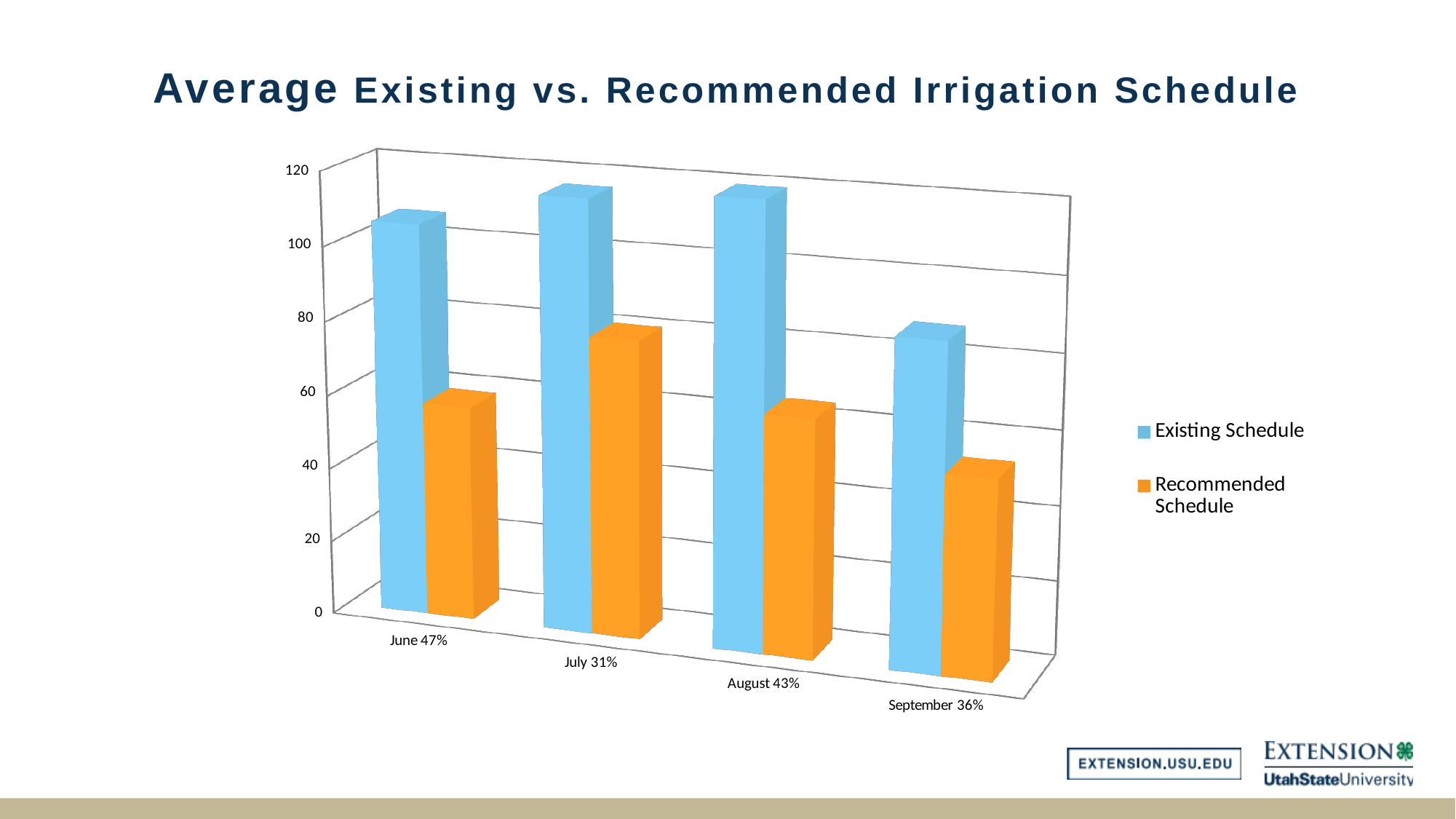
Which colour represents the Recommended Schedule series in the legend? orange How many series does the legend list? 2 What kind of chart is shown on the slide? bar chart For August 43%, which is larger: the Existing Schedule or the Recommended Schedule? Existing Schedule Which month has the lowest Existing Schedule value? September 36% Is the Recommended Schedule value for September 36% greater or less than 60? less Which month has the lowest Recommended Schedule value? September 36% Is the Recommended Schedule value for June 47% greater or less than 80? less Is the Existing Schedule value for September 36% greater or less than 100? less How many months (categories) are shown on the x axis? 4 Which month has the highest Recommended Schedule value? July 31%